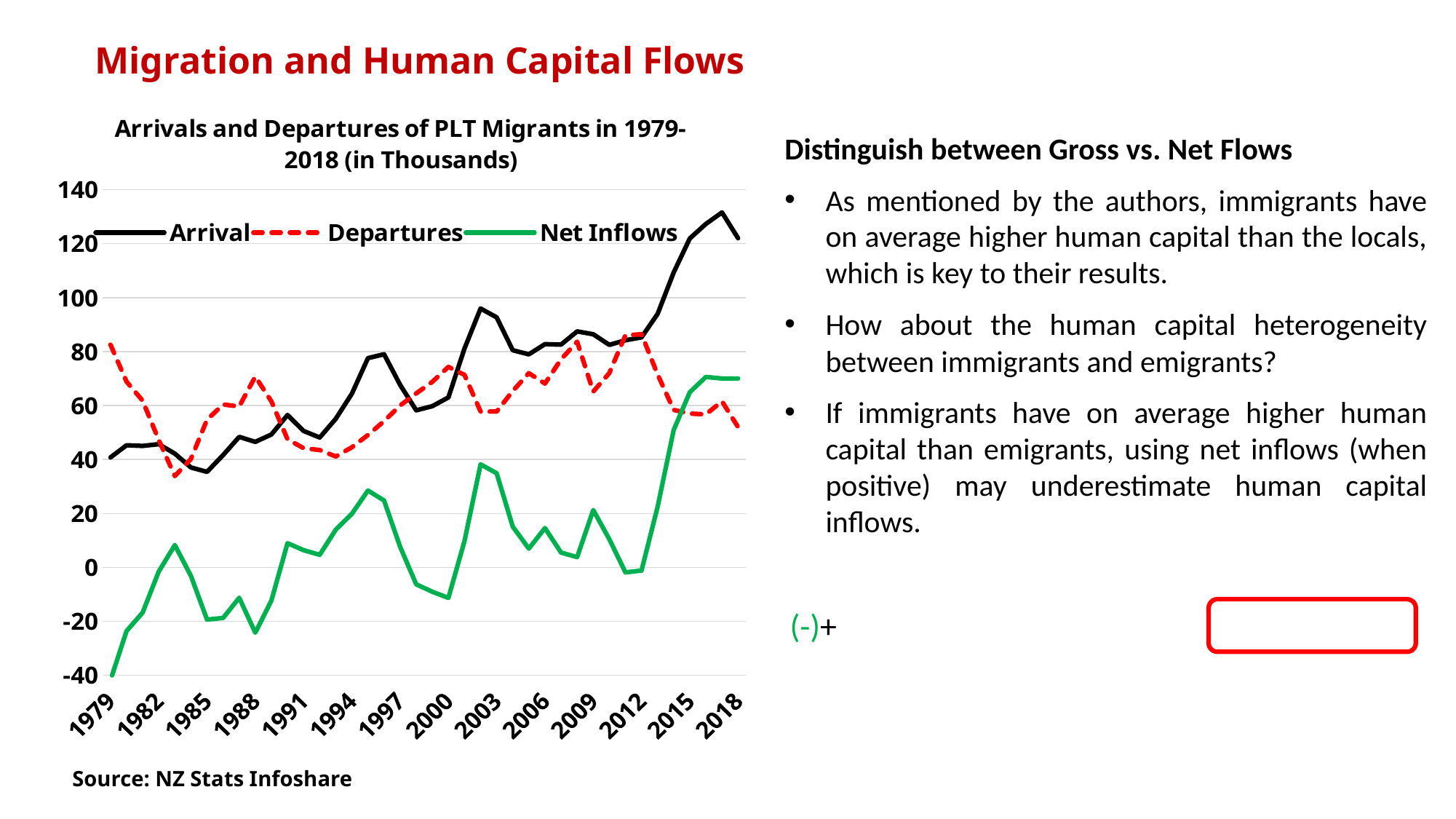
Is the value for Arrival in 1979 greater or less than 60? less Which series reaches the lowest value on the chart? Net Inflows Is the value for Net Inflows in 1979 greater or less than -20? less What is the title of the chart? Arrivals and Departures of PLT Migrants in 1979-2018 (in Thousands) Does the Arrival series overall rise or fall from 1979 to 2018? Rise Is the value for Arrival in 2018 greater or less than 100? greater How many year labels are shown on the x axis? 14 What kind of chart is shown on the slide? Line chart Which series is drawn as a red dashed line? Departures In 2018, which is larger, Arrival or Departures? Arrival How many series does the chart's legend list? 3